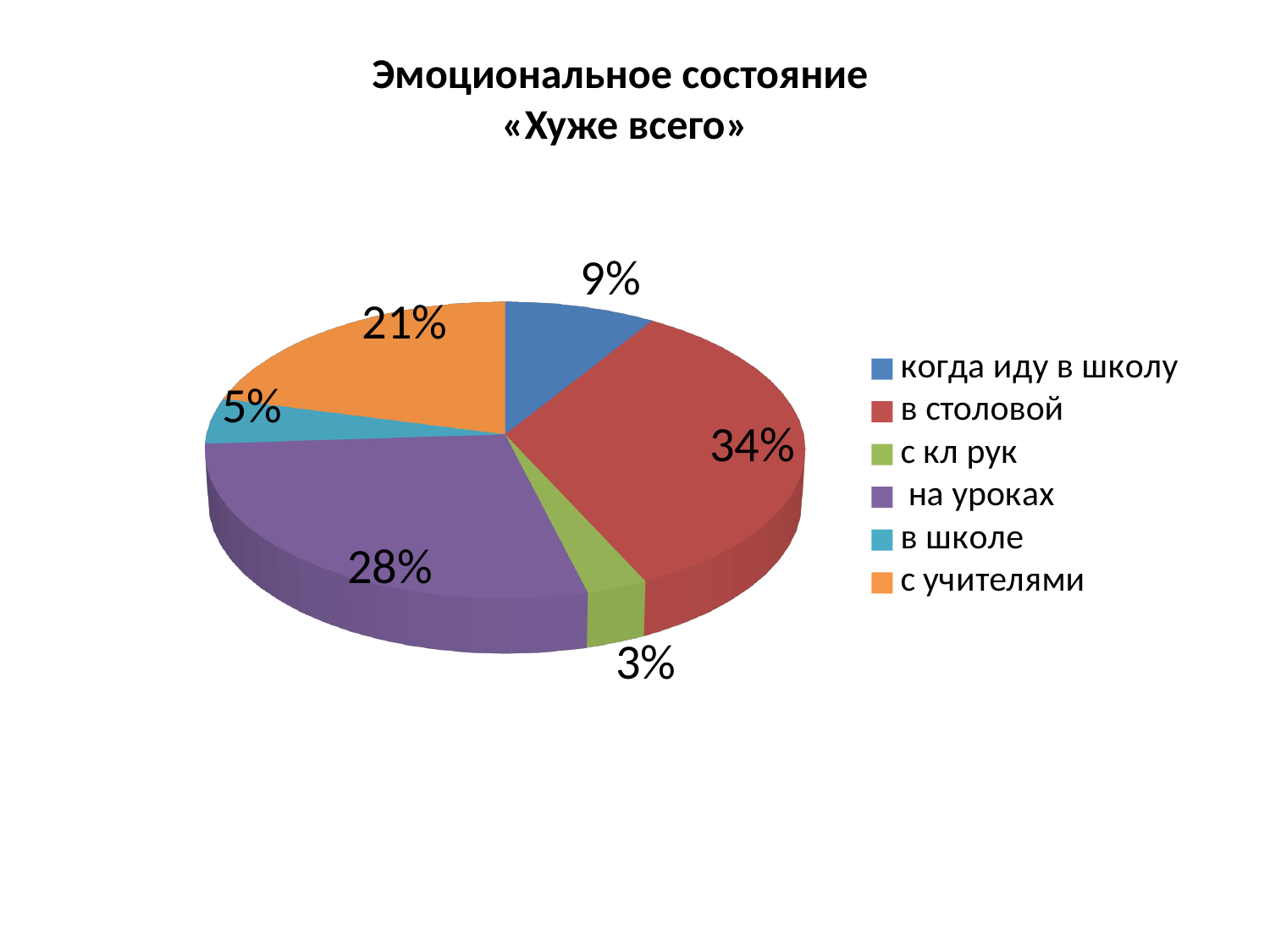
What is the value for «в столовой»? 34% Which is larger, the value for «с учителями» or the value for «когда иду в школу»? с учителями What is the value for «с кл рук»? 3% What is the value for «с учителями»? 21% Which category has the smallest share of the pie? с кл рук What is the value for «когда иду в школу»? 9% What is the value for «на уроках»? 28% What kind of chart is shown on the slide? Pie chart Which category has the largest share of the pie? в столовой How many categories does the pie chart have? 6 What is the title of the chart? Эмоциональное состояние «Хуже всего» What is the difference between the values for «в столовой» and «на уроках»? 6%